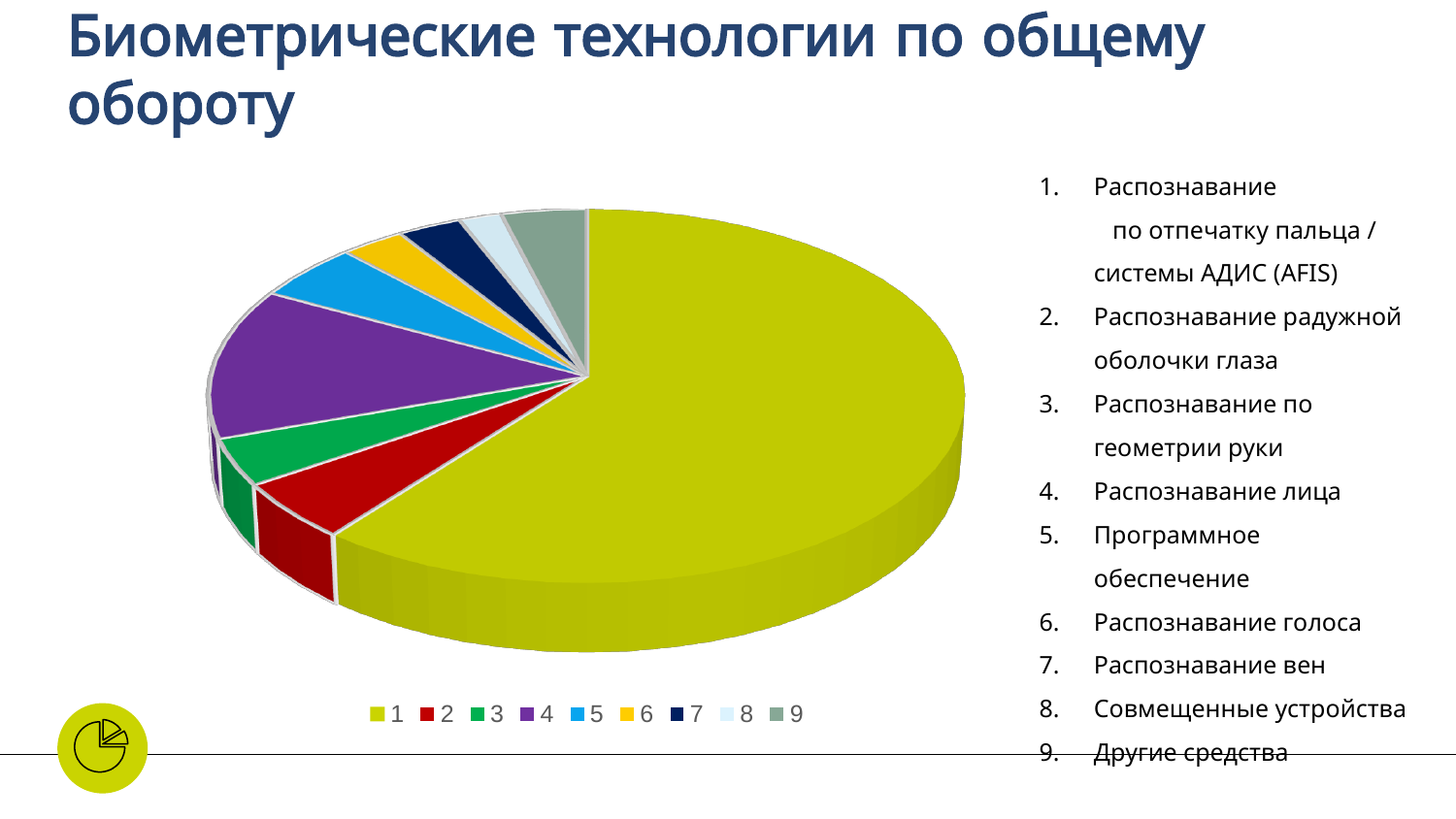
What is the title of the slide containing the pie chart? Биометрические технологии по общему обороту Which slice is larger in the pie chart, slice 1 or slice 4? 1 How many entries does the legend of the pie chart list? 9 Does slice 1 take up more or less than half of the pie chart? more Which slice is larger in the pie chart, slice 4 or slice 2? 4 Which slice is larger in the pie chart, slice 2 or slice 7? 2 What kind of chart is shown on the slide? pie chart What colour is slice 1, the largest slice of the pie chart? yellow-green Which slice of the pie chart is the largest? 1 How many slices does the pie chart have? 9